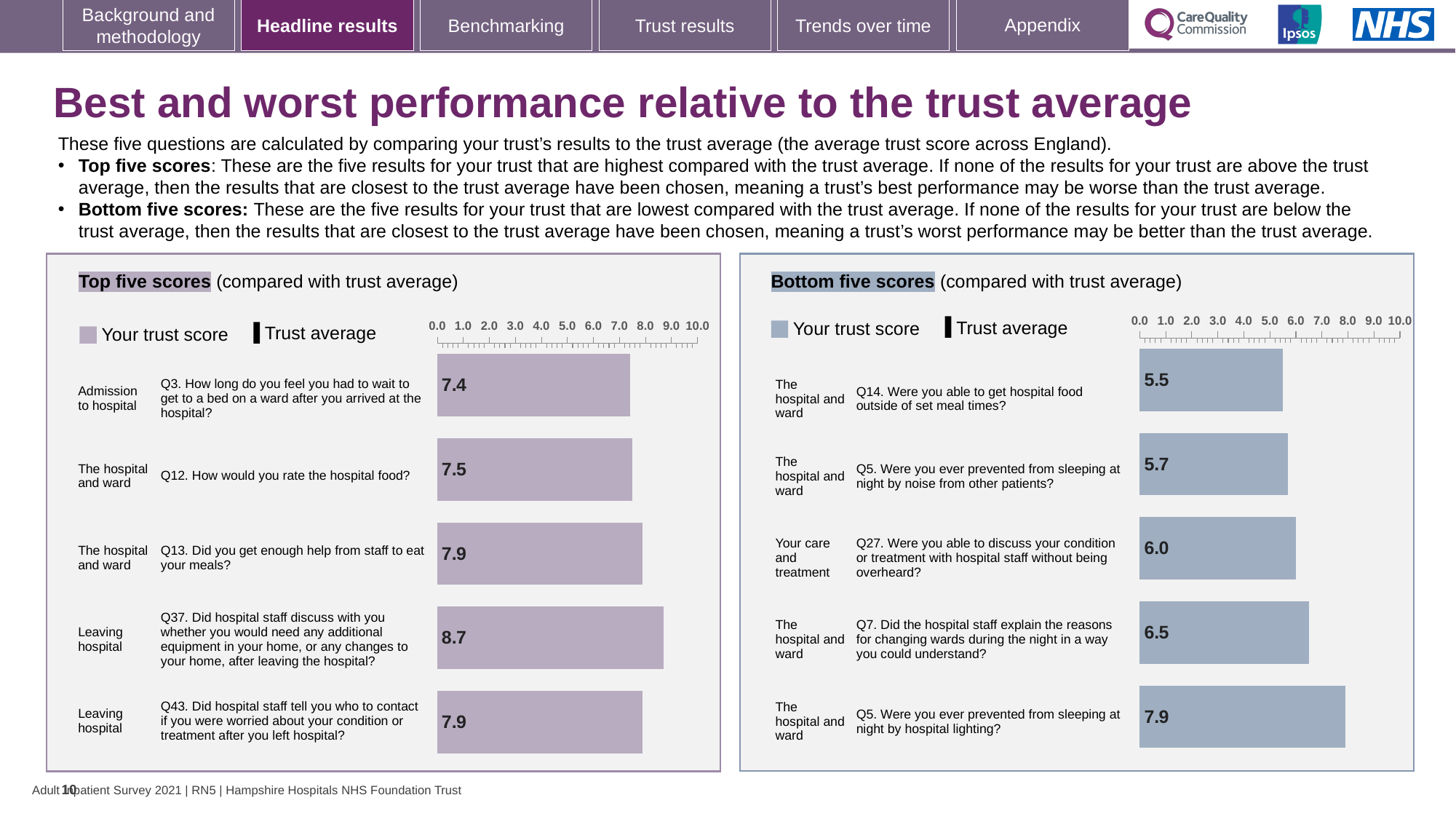
In the Bottom five scores chart, which question has the lowest trust score? Q14 In the Bottom five scores chart, what is the trust score for Q14 (Were you able to get hospital food outside of set meal times?)? 5.5 What kind of chart is the Bottom five scores chart? Bar chart In the Top five scores chart, what is the trust score for Q12 (How would you rate the hospital food?)? 7.5 In the Top five scores chart, which question has the highest trust score? Q37 In the Top five scores chart, what is the difference between the trust score for Q37 and the trust score for Q3? 1.3 In the Bottom five scores chart, what is the difference between the trust score for Q5 (hospital lighting) and the trust score for Q14? 2.4 In the Bottom five scores chart, is the trust score for Q27 greater or less than 5.0? greater How many entries does the legend of the Top five scores chart list? 2 In the Top five scores chart, which has the larger trust score: Q13 or Q3? Q13 How many questions are shown in the Top five scores chart? 5 In the Top five scores chart, what is the trust score for Q43 (Did hospital staff tell you who to contact if you were worried about your condition or treatment after you left hospital?)? 7.9